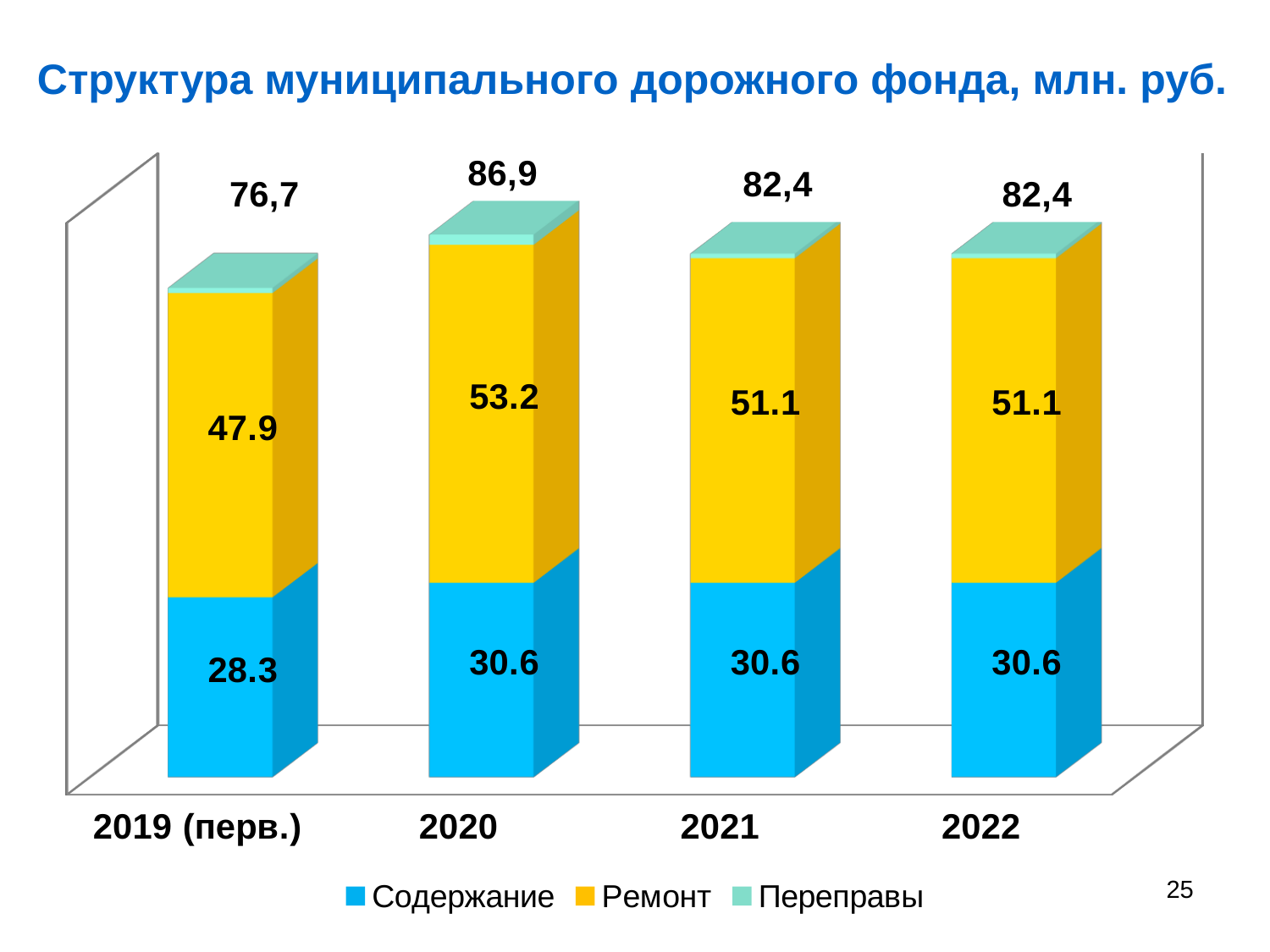
Which year has the lowest total value? 2019 (перв.) How many series does the legend list? 3 Which year has the highest total value? 2020 What is the difference between Ремонт and Содержание in 2021? 20.5 By how much does Ремонт in 2020 exceed Ремонт in 2019 (перв.)? 5.3 Which is larger: Содержание in 2019 (перв.) or Содержание in 2020? 2020 What kind of chart is shown on the slide? Stacked bar chart Does the value of Ремонт rise or fall from 2020 to 2021? Fall What is the value of Содержание for 2019 (перв.)? 28.3 What is the total of the stacked bar for 2021? 82,4 How many years are shown on the x axis? 4 What is the value of Ремонт for 2020? 53.2